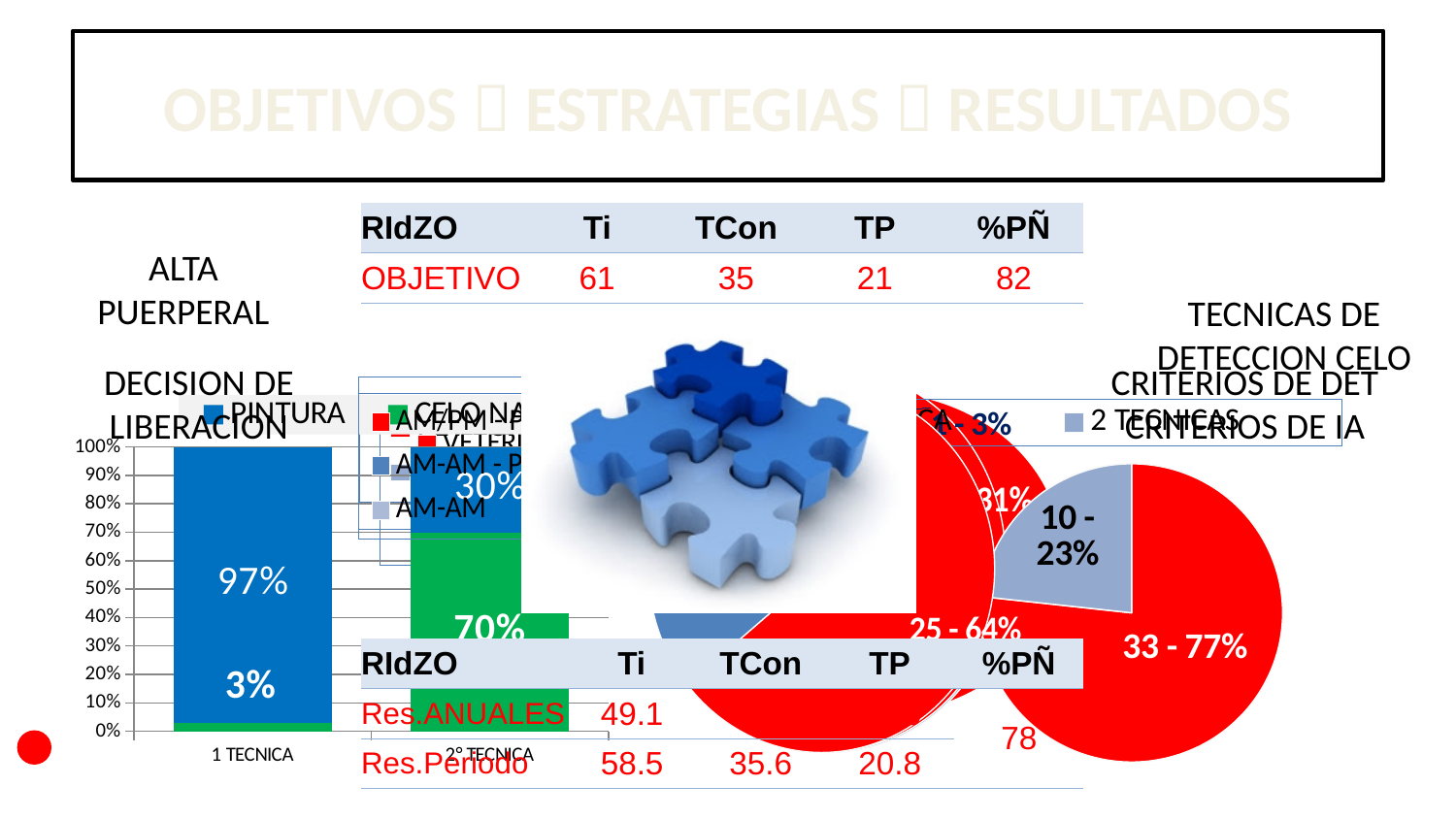
What kind of chart is the 'DECISION DE LIBERACION' chart? Stacked bar chart In the 'DECISION DE LIBERACION' chart, what is the value of the PINTURA series for '1 TECNICA'? 97% In the 'DECISION DE LIBERACION' chart, what is the value of the green segment for '2° TECNICA'? 70% In the 'DECISION DE LIBERACION' chart, which category has the higher PINTURA value, '1 TECNICA' or '2° TECNICA'? 1 TECNICA In the 'DECISION DE LIBERACION' chart, what is the difference between the PINTURA values for '1 TECNICA' and '2° TECNICA'? 67% In the 'CRITERIOS DE IA' pie chart, what is the label of the smaller (blue-grey) slice? 10 - 23% In the 'CRITERIOS DE IA' pie chart, what is the label of the largest (red) slice? 33 - 77% In the 'DECISION DE LIBERACION' chart, what is the value of the PINTURA series for '2° TECNICA'? 30% In the 'DECISION DE LIBERACION' chart, does the PINTURA value rise or fall from '1 TECNICA' to '2° TECNICA'? Fall In the 'DECISION DE LIBERACION' chart, how many categories are shown on the x axis? 2 What kind of chart is the 'CRITERIOS DE IA' chart? Pie chart In the 'DECISION DE LIBERACION' chart, what is the value of the lower (green) segment for '1 TECNICA'? 3%